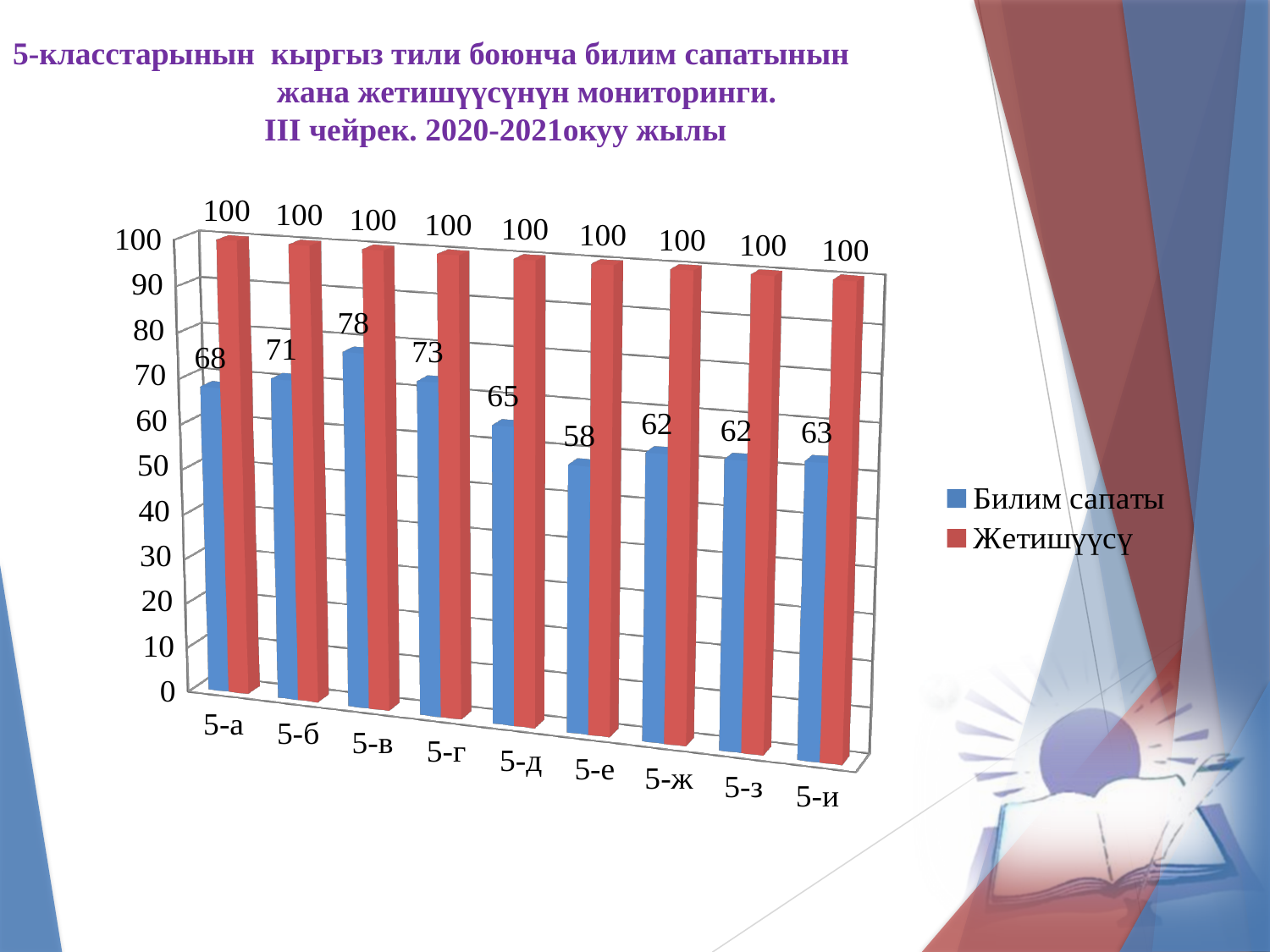
Which is larger, the Билим сапаты value for 5-б or for 5-г? 5-г What kind of chart is shown on the slide? bar chart Which class has the highest Билим сапаты value? 5-в What is the value of Билим сапаты for 5-в? 78 How many classes are shown on the x axis? 9 What is the difference between the Жетишүүсү and Билим сапаты values for 5-а? 32 How many series does the legend list? 2 Which series is shown in red? Жетишүүсү Which class has the lowest Билим сапаты value? 5-е What is the value of Жетишүүсү for 5-д? 100 What is the difference between the Билим сапаты values for 5-в and 5-е? 20 What is the value of Билим сапаты for 5-е? 58